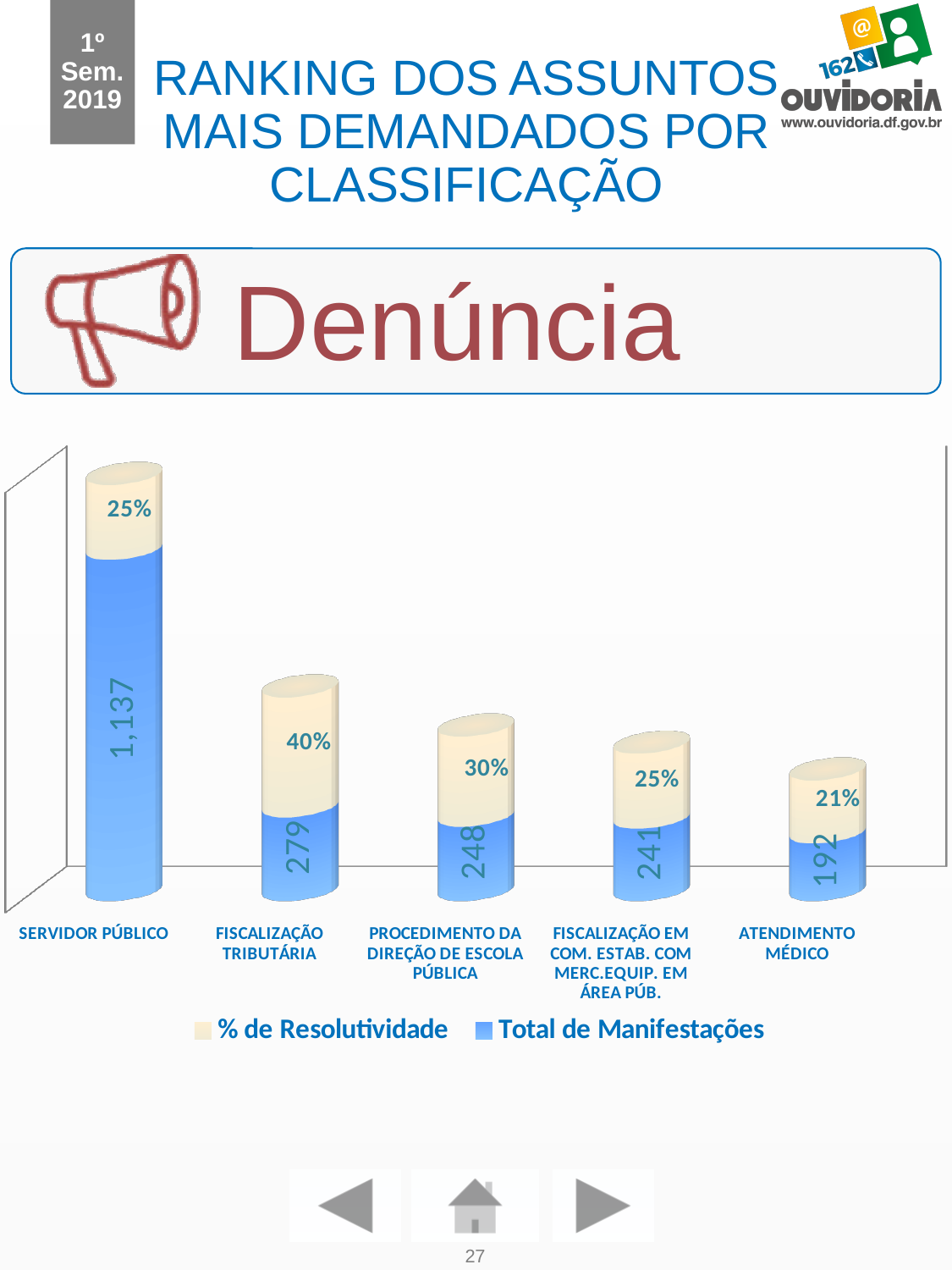
Which has a larger Total de Manifestações, PROCEDIMENTO DA DIREÇÃO DE ESCOLA PÚBLICA or ATENDIMENTO MÉDICO? PROCEDIMENTO DA DIREÇÃO DE ESCOLA PÚBLICA What kind of chart is shown on the slide? Bar chart How many series does the legend list? 2 What is the Total de Manifestações for ATENDIMENTO MÉDICO? 192 Which category has the highest % de Resolutividade? FISCALIZAÇÃO TRIBUTÁRIA What is the % de Resolutividade for PROCEDIMENTO DA DIREÇÃO DE ESCOLA PÚBLICA? 30% How many categories are shown in the chart? 5 What is the % de Resolutividade for FISCALIZAÇÃO TRIBUTÁRIA? 40% Which category has the lowest % de Resolutividade? ATENDIMENTO MÉDICO What is the Total de Manifestações for SERVIDOR PÚBLICO? 1,137 What is the difference in Total de Manifestações between FISCALIZAÇÃO TRIBUTÁRIA and ATENDIMENTO MÉDICO? 87 Which category has the highest Total de Manifestações? SERVIDOR PÚBLICO